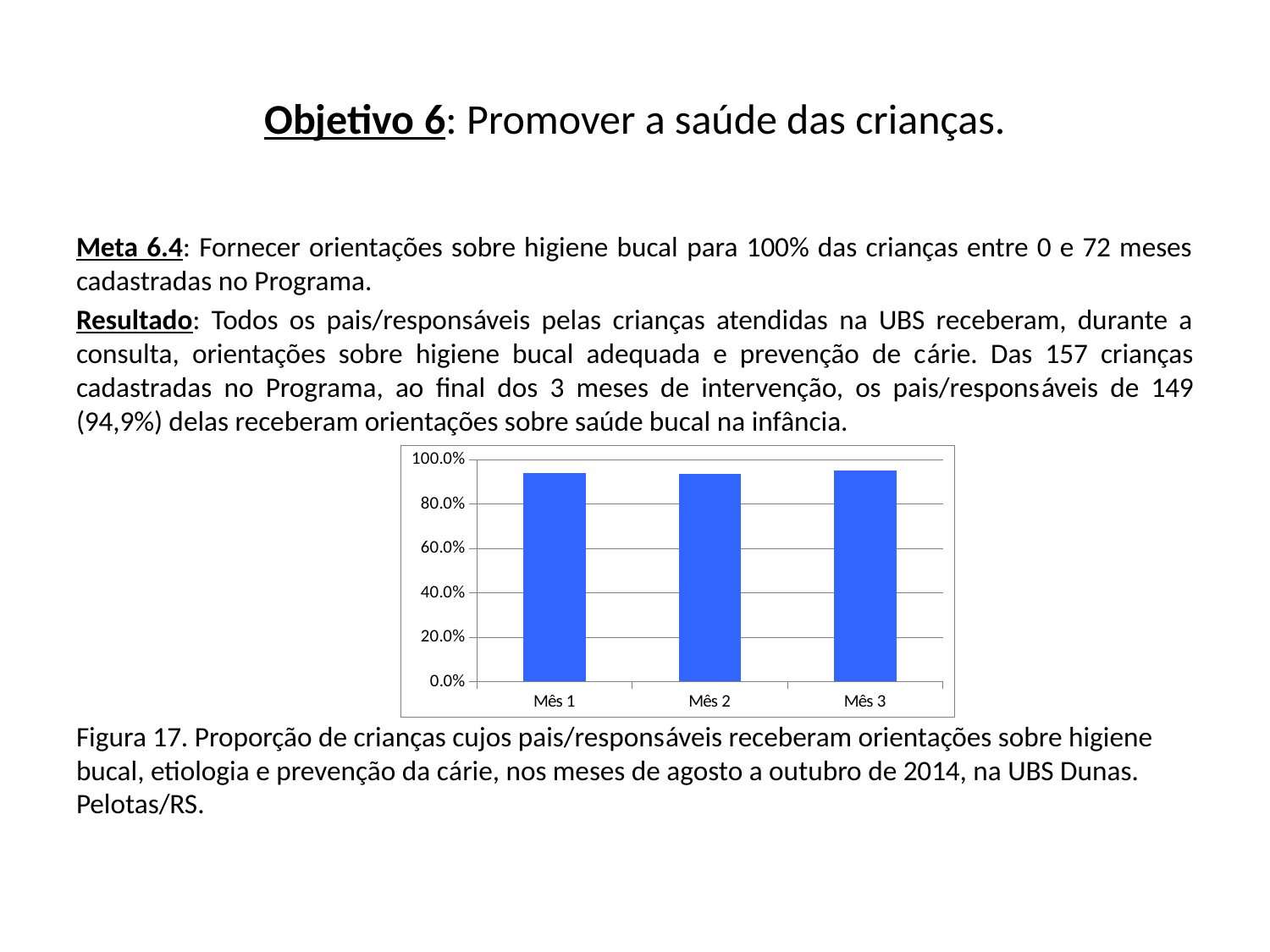
How many bars (categories) does the chart show? 3 What kind of chart is shown on the slide? bar chart Is the value for Mês 3 greater or less than 80.0%? greater What is the highest value shown on the y axis of the chart? 100.0% Is the value for Mês 1 greater or less than 60.0%? greater Is the value for Mês 1 greater or less than 80.0%? greater What are the category labels on the x axis of the chart? Mês 1, Mês 2, Mês 3